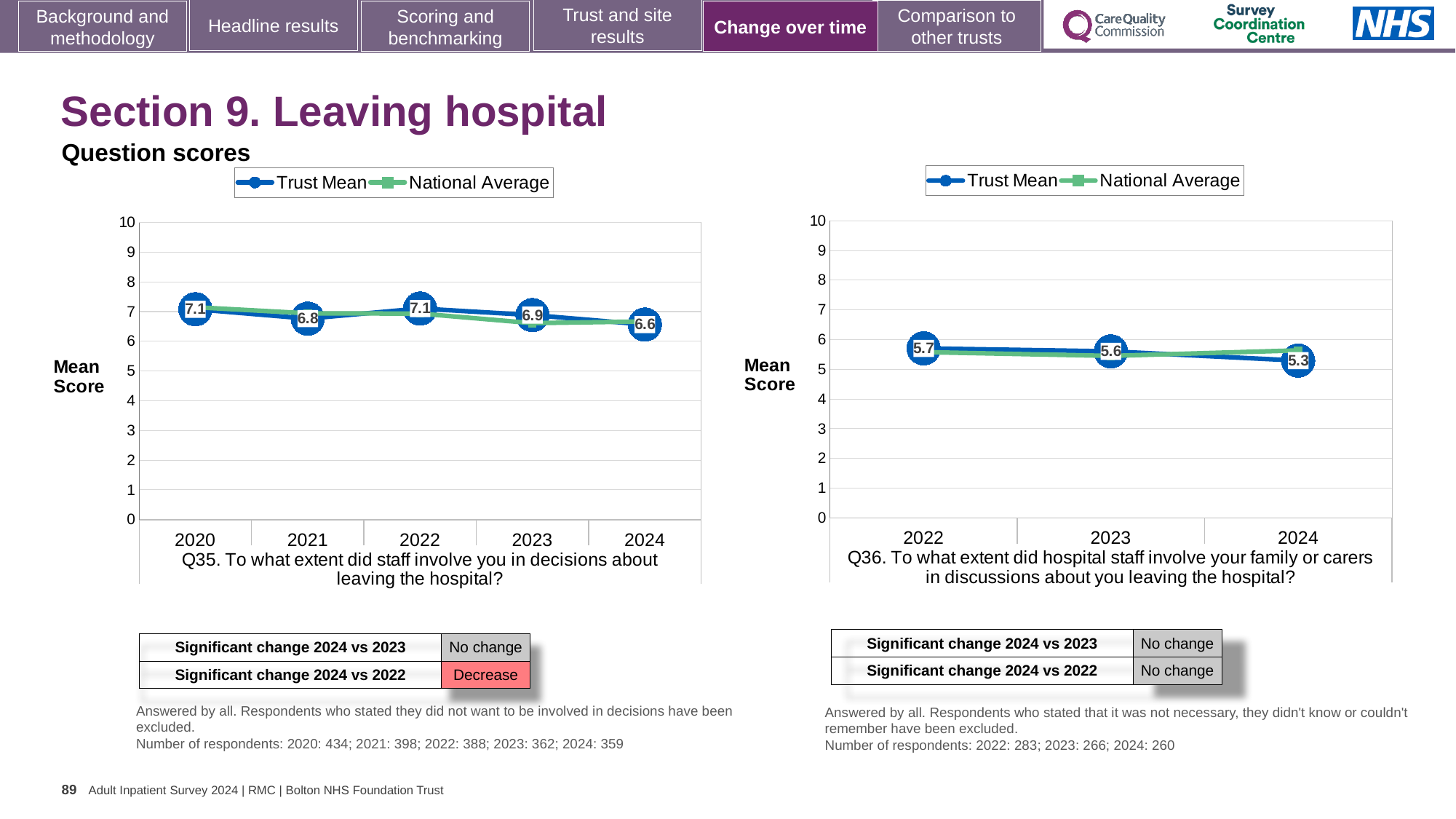
How many series does the legend of the Q35 chart (left) list? 2 In the Q35 chart (left), is the Trust Mean score higher in 2021 or in 2022? 2022 In the Q36 chart (right), does the Trust Mean score rise or fall from 2022 to 2024? Fall In the Q35 chart (left), which year has the lowest Trust Mean score? 2024 What type of chart is used for Q35 (left)? Line chart In the Q36 chart (right), what is the Trust Mean score for 2023? 5.6 In the Q36 chart (right), what is the difference between the Trust Mean scores for 2022 and 2024? 0.4 How many years are plotted on the x axis of the Q36 chart (right)? 3 In the Q35 chart (left), is the National Average value for 2024 greater or less than 6? greater In the Q36 chart (right), which year has the highest Trust Mean score? 2022 In the Q35 chart (left), what is the Trust Mean score for 2024? 6.6 In the Q35 chart (left), what is the Trust Mean score for 2020? 7.1